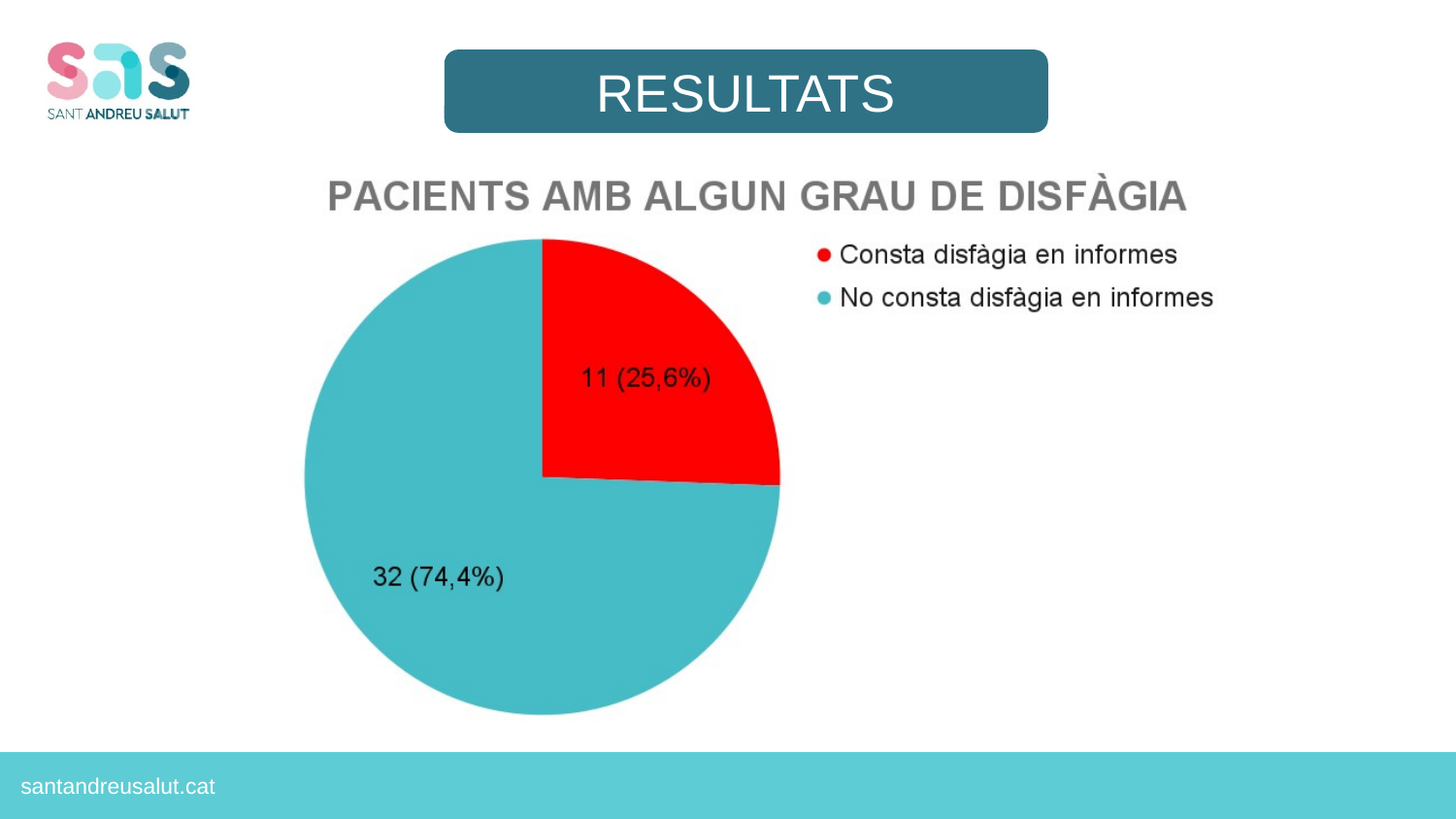
How many patients are in the 'Consta disfàgia en informes' slice? 11 How many entries does the legend list? 2 Which slice is the largest? No consta disfàgia en informes What share of the pie does 'No consta disfàgia en informes' represent? 74,4% Which colour represents 'Consta disfàgia en informes' in the chart? red How many slices does the pie chart have? 2 Which slice is the smallest? Consta disfàgia en informes How many patients are in the 'No consta disfàgia en informes' slice? 32 What is the title of the chart? PACIENTS AMB ALGUN GRAU DE DISFÀGIA What share of the pie does 'Consta disfàgia en informes' represent? 25,6% What kind of chart is shown on the slide? pie chart What is the difference in patient count between 'No consta disfàgia en informes' and 'Consta disfàgia en informes'? 21